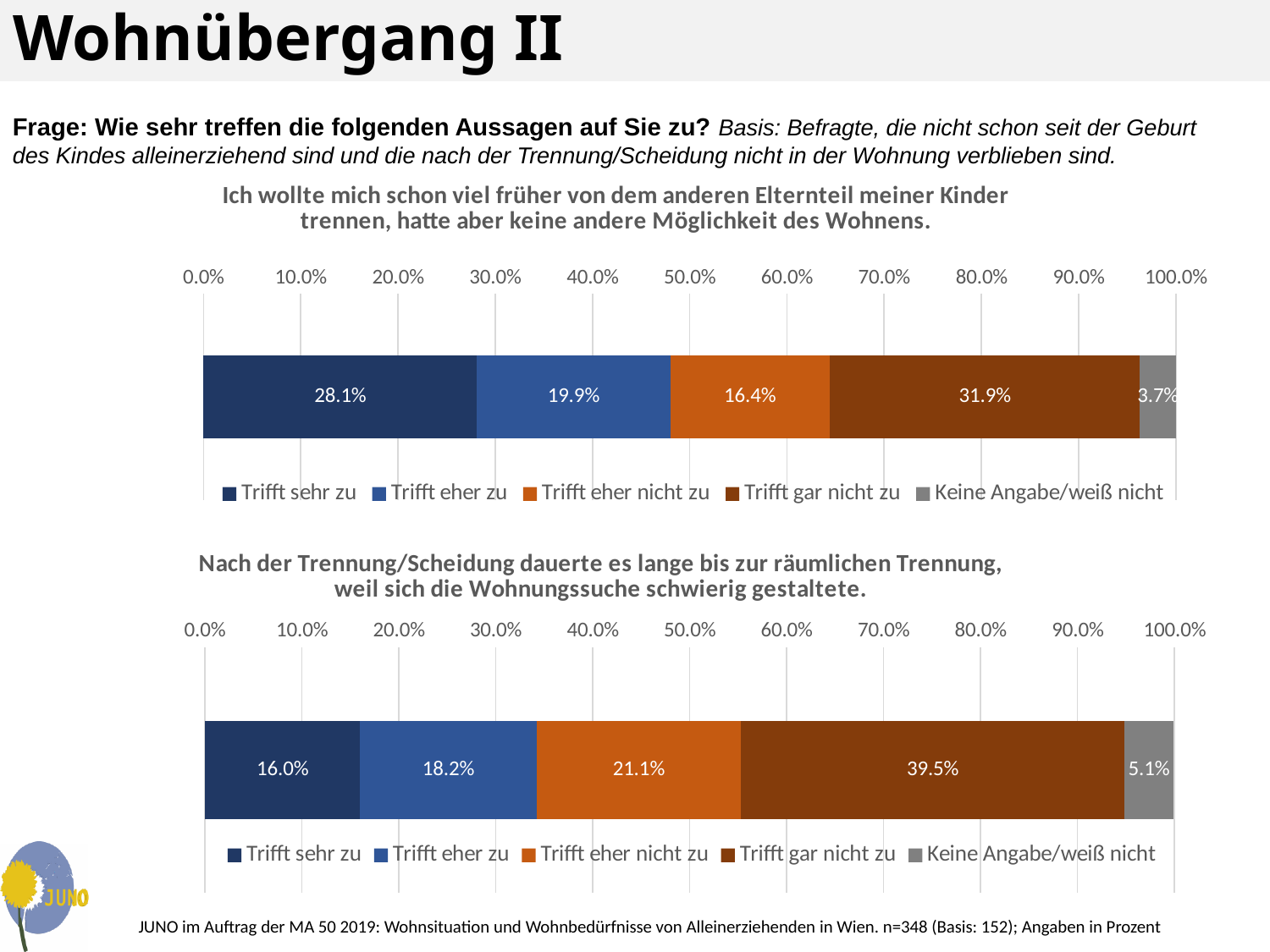
In the bottom chart, which response category has the lowest value? Keine Angabe/weiß nicht What is the title of the bottom chart? Nach der Trennung/Scheidung dauerte es lange bis zur räumlichen Trennung, weil sich die Wohnungssuche schwierig gestaltete. In the top chart ("Ich wollte mich schon viel früher..."), what is the value for "Trifft sehr zu"? 28.1% In the bottom chart ("Nach der Trennung/Scheidung dauerte es lange..."), what is the value for "Keine Angabe/weiß nicht"? 5.1% In the bottom chart ("Nach der Trennung/Scheidung dauerte es lange..."), what is the value for "Trifft eher nicht zu"? 21.1% In the top chart, what is the combined value of "Trifft sehr zu" and "Trifft eher zu"? 48.0% In the bottom chart, what is the difference between "Trifft gar nicht zu" and "Trifft sehr zu"? 23.5% What kind of chart is the bottom chart? Stacked bar chart In the top chart ("Ich wollte mich schon viel früher..."), what is the value for "Trifft gar nicht zu"? 31.9% In the top chart, which is larger: "Trifft eher zu" or "Trifft eher nicht zu"? Trifft eher zu How many series does the legend of the top chart list? 5 In the top chart, which response category has the highest value? Trifft gar nicht zu